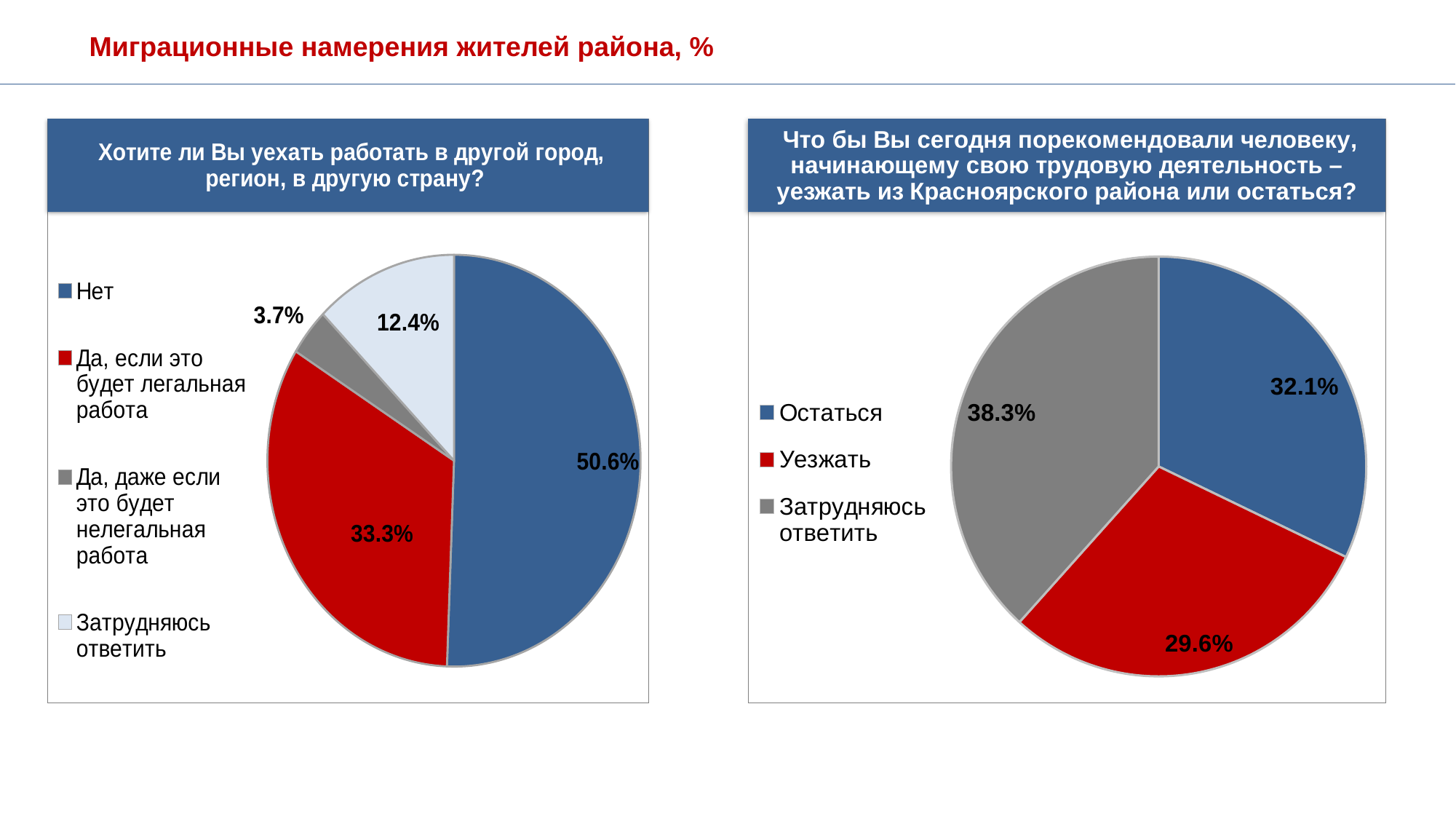
In the left chart, what is the value for "Да, даже если это будет нелегальная работа"? 3.7% In the right chart, how many entries does the legend list? 3 In the right chart, what is the value for "Уезжать"? 29.6% In the left chart ("Хотите ли Вы уехать работать в другой город, регион, в другую страну?"), what share of respondents answered "Нет"? 50.6% In the left chart, how many slices does the pie have? 4 In the left chart, what is the difference between the "Нет" slice and the "Да, если это будет легальная работа" slice? 17.3% In the left chart, what is the value for "Да, если это будет легальная работа"? 33.3% In the right chart ("Что бы Вы сегодня порекомендовали человеку..."), what is the value for "Остаться"? 32.1% In the left chart, which category has the smallest slice? Да, даже если это будет нелегальная работа In the right chart, which is larger: "Остаться" or "Уезжать"? Остаться What type of chart is used on the right side of the slide? Pie chart In the right chart, which category has the largest slice? Затрудняюсь ответить